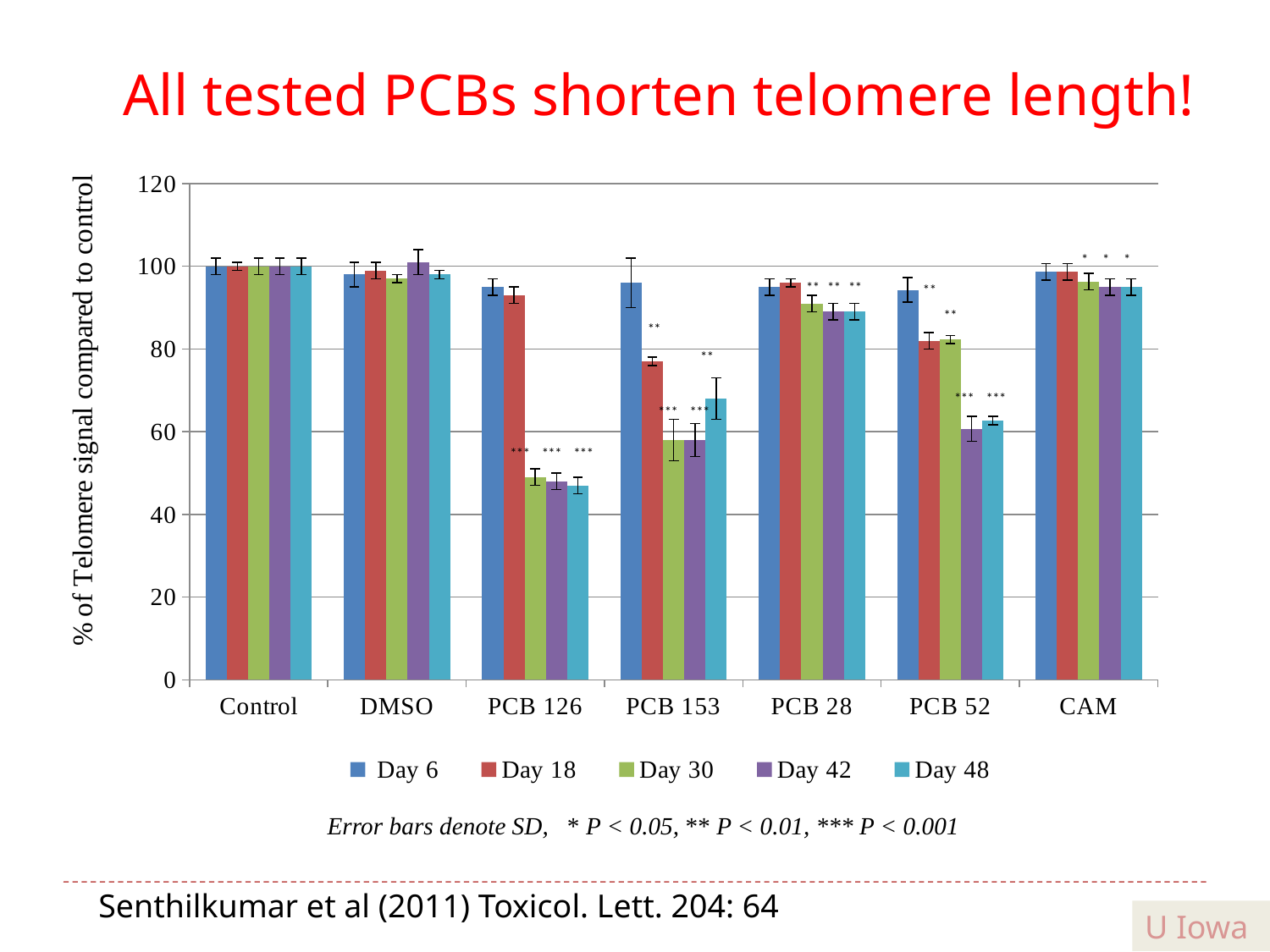
How many categories are shown on the x axis of the chart? 7 Is the value for Day 48 in the PCB 153 category greater or less than 60? greater What kind of chart is shown on the slide? bar chart Which series is shown in red in the legend? Day 18 In the PCB 126 category, which is larger: the Day 18 value or the Day 30 value? Day 18 What is the value for Day 6 in the Control category? 100 Is the value for Day 42 in the PCB 28 category greater or less than 80? greater Which category has the lowest Day 48 value? PCB 126 Is the value for Day 18 in the PCB 126 category greater or less than 80? greater How many series does the chart's legend list? 5 What is the title of the y axis? % of Telomere signal compared to control